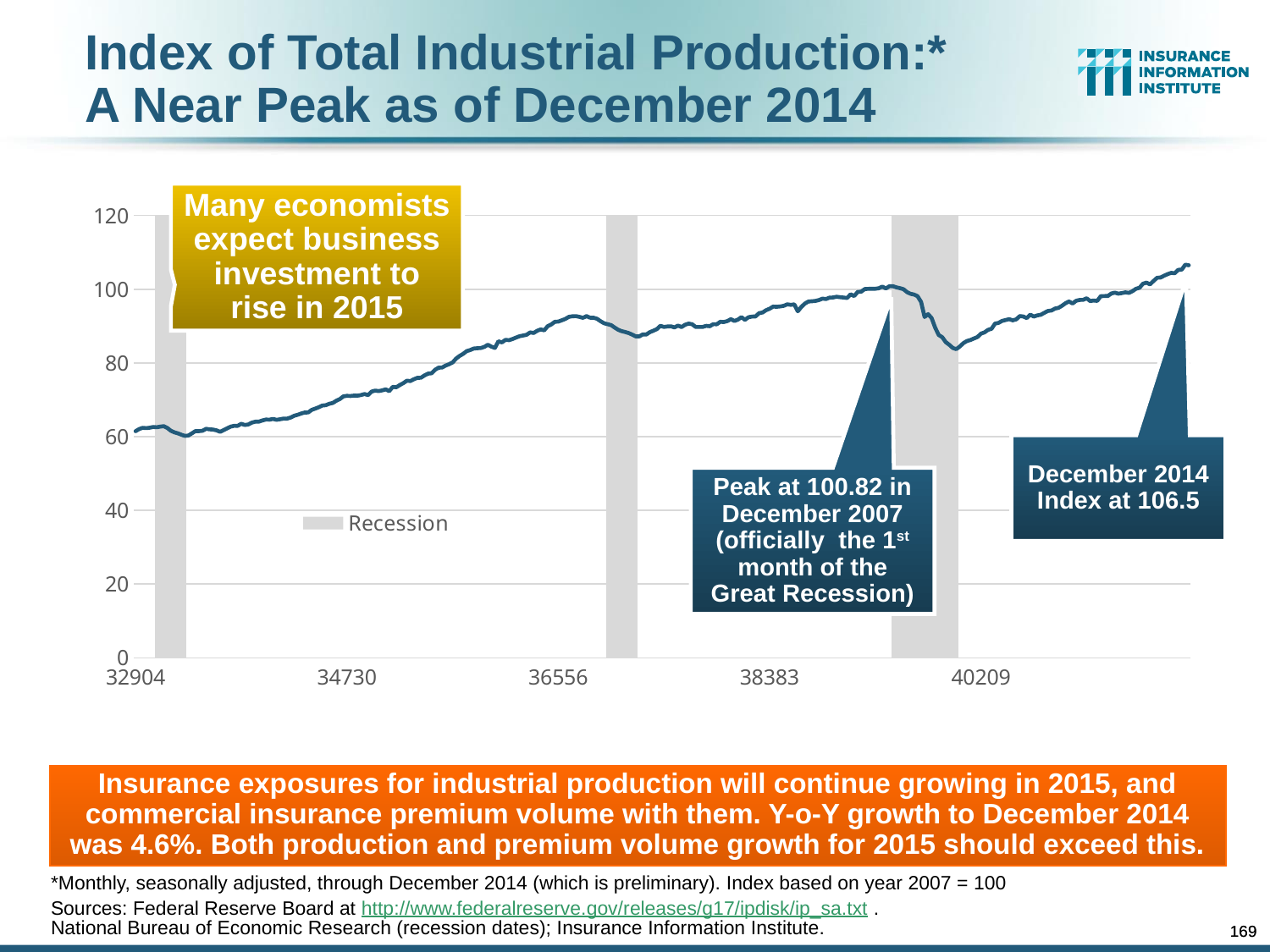
What is the highest tick value shown on the y axis? 120 Over the whole period shown, does the index generally rise or fall along the x axis? rise Is the index value at x = 40209 greater or less than 100? less What kind of chart is shown on the slide? line chart What was the peak value of the Index of Total Industrial Production in December 2007? 100.82 Which is higher: the December 2007 peak or the December 2014 index value? December 2014 How many shaded recession periods are shown on the chart? 3 What does the grey shading in the chart represent, according to the legend? Recession Is the index value at x = 36556 greater or less than 80? greater Is the index value at the start of the series (x = 32904) greater or less than 80? less What was the Index of Total Industrial Production in December 2014? 106.5 By how much does the December 2014 index (106.5) exceed the December 2007 peak (100.82)? 5.68